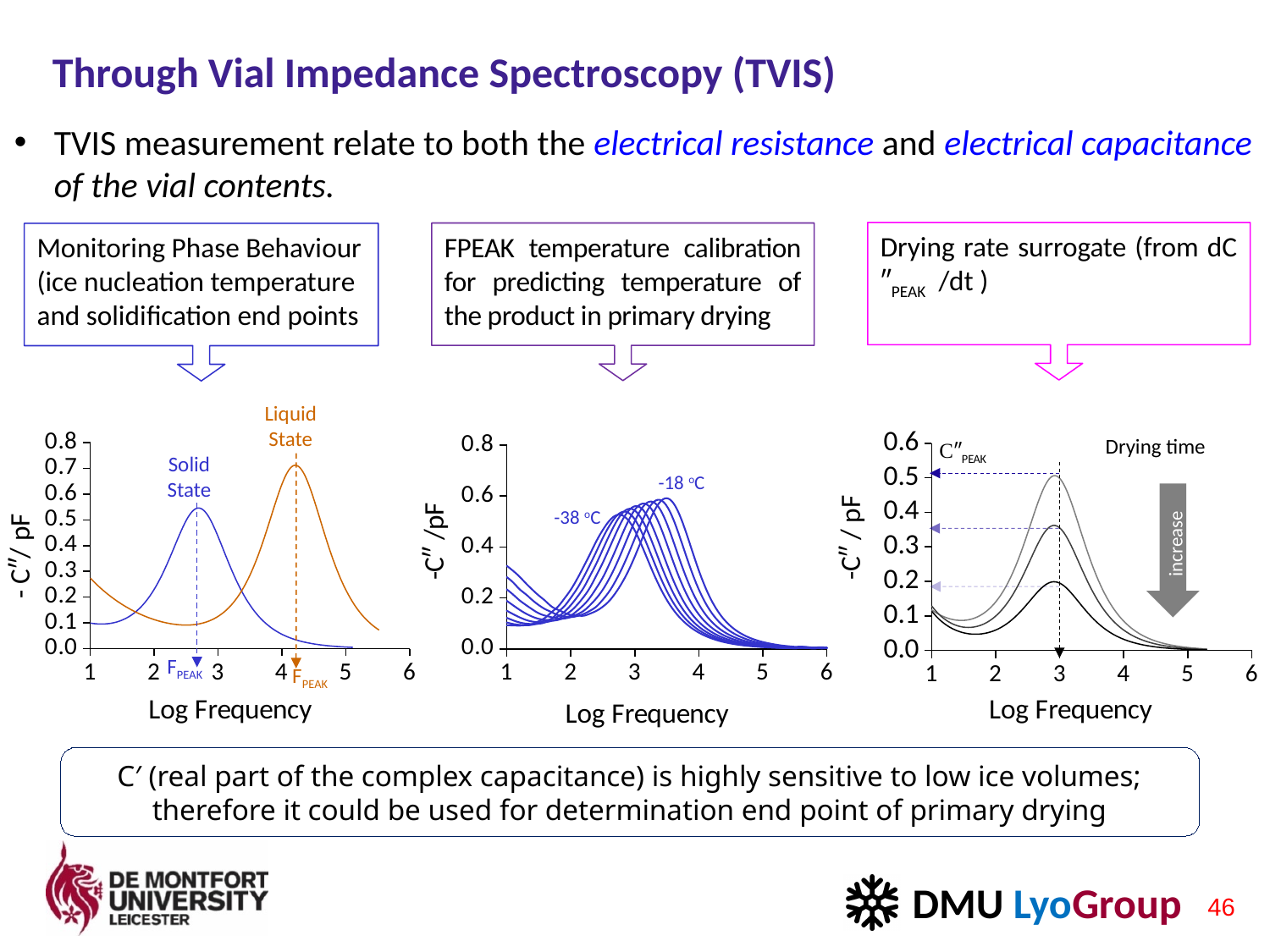
In the left chart, is the peak value of the Liquid State curve greater or less than 0.6? greater How many curves are plotted in the left chart? 2 What is the x-axis label of the left chart? Log Frequency What kind of chart is the left chart showing the Solid State and Liquid State curves? line chart In the left chart, which curve reaches the higher peak, Solid State or Liquid State? Liquid State In the left chart, does the Solid State peak occur at a lower or higher log frequency than the Liquid State peak? lower In the right chart, is the highest peak value greater or less than 0.4? greater In the middle chart, is the peak value of the -18 °C curve greater or less than 0.4? greater In the right chart, how many curves are plotted? 3 In the middle chart, which two temperatures are labelled on the curves? -38 °C and -18 °C